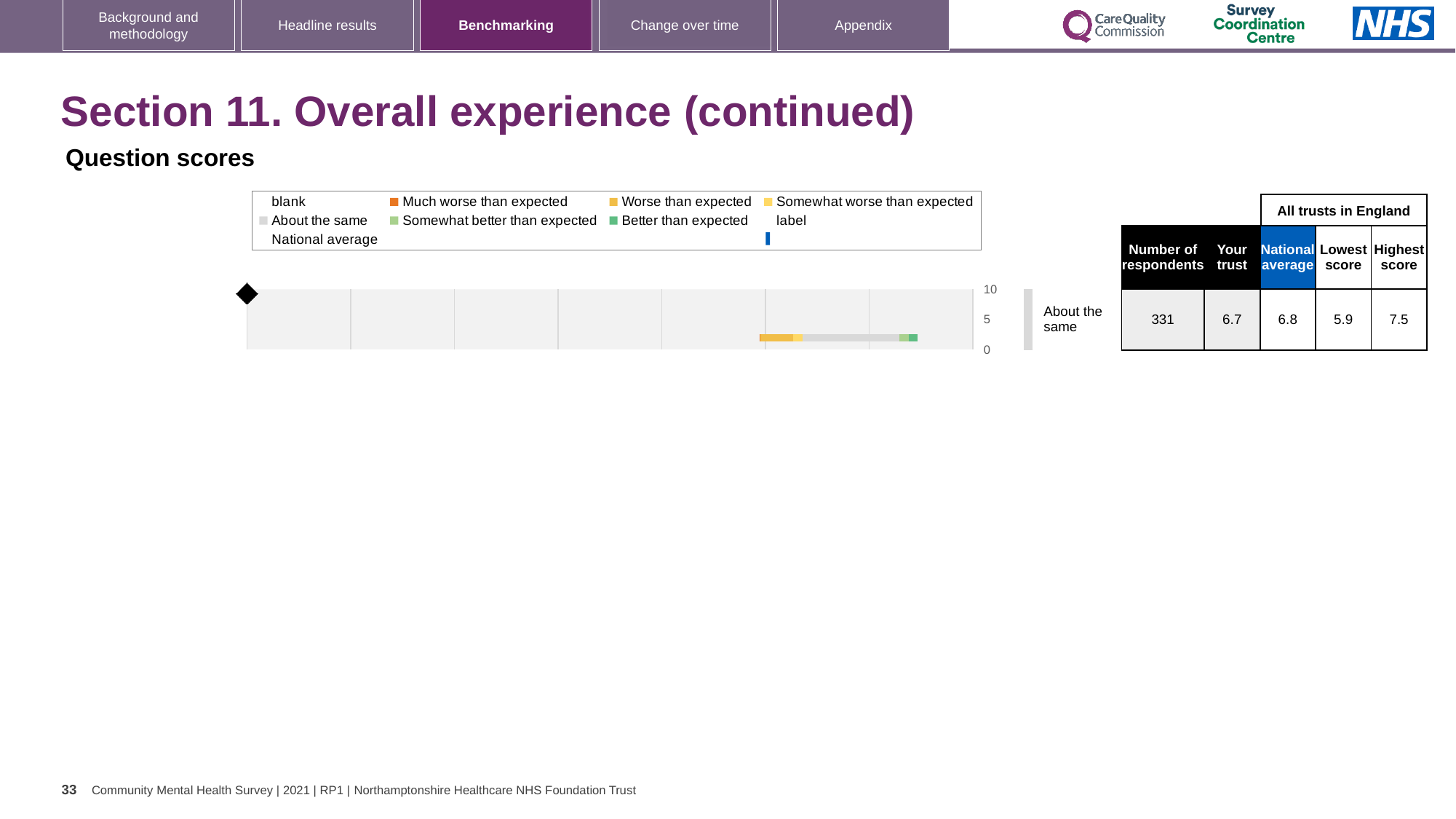
How many respondents answered this question? 331 What is the difference between the national average and the 'Your trust' score? 0.1 What is the 'Your trust' score for the 'About the same' question? 6.7 Which is larger for this question: the 'Your trust' score or the national average? National average What is the category label shown next to the bar in the chart? About the same What is the highest score among all trusts in England for this question? 7.5 How many question categories are plotted in the chart? 1 What is the difference between the highest score and the lowest score among all trusts in England? 1.6 What kind of chart is shown on the slide? bar chart What is the maximum value shown on the chart's score axis? 10 What is the lowest score among all trusts in England for this question? 5.9 What is the national average score for the 'About the same' question? 6.8